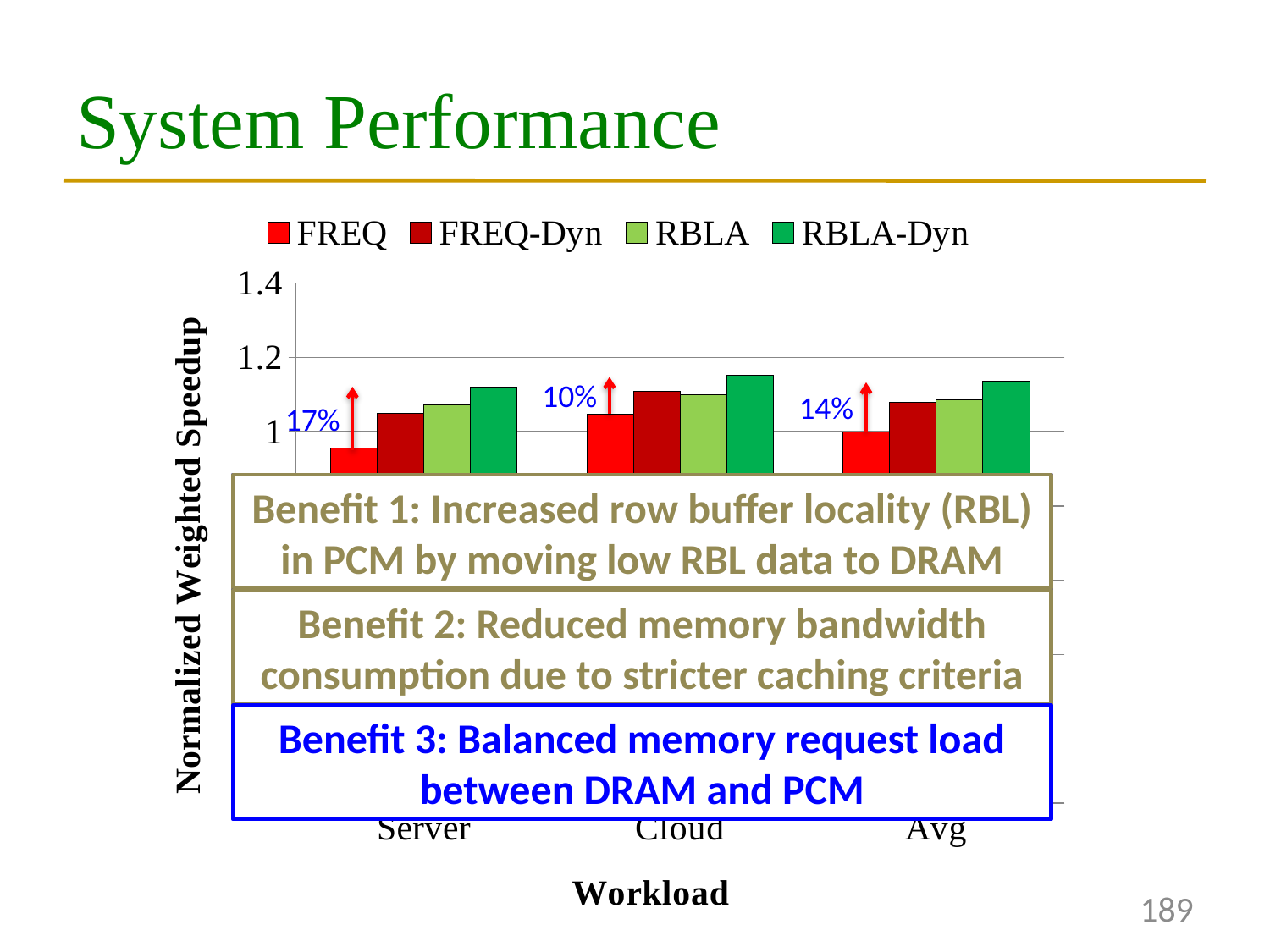
For the Server workload, which is larger: the FREQ bar or the RBLA-Dyn bar? RBLA-Dyn How many workload categories are shown on the x axis? 3 What percentage improvement is annotated above the Cloud workload group? 10% How many series does the legend list? 4 What is the title of the y axis? Normalized Weighted Speedup Is the value for FREQ in the Cloud workload greater or less than 1? greater Which series has the lowest bar for the Cloud workload? FREQ Is the value for FREQ in the Server workload greater or less than 1? less Is the value for RBLA-Dyn in the Server workload greater or less than 1.2? less Which series has the lowest bar for the Avg workload? FREQ What kind of chart is shown on the slide? bar chart Which series has the highest bar for the Server workload? RBLA-Dyn